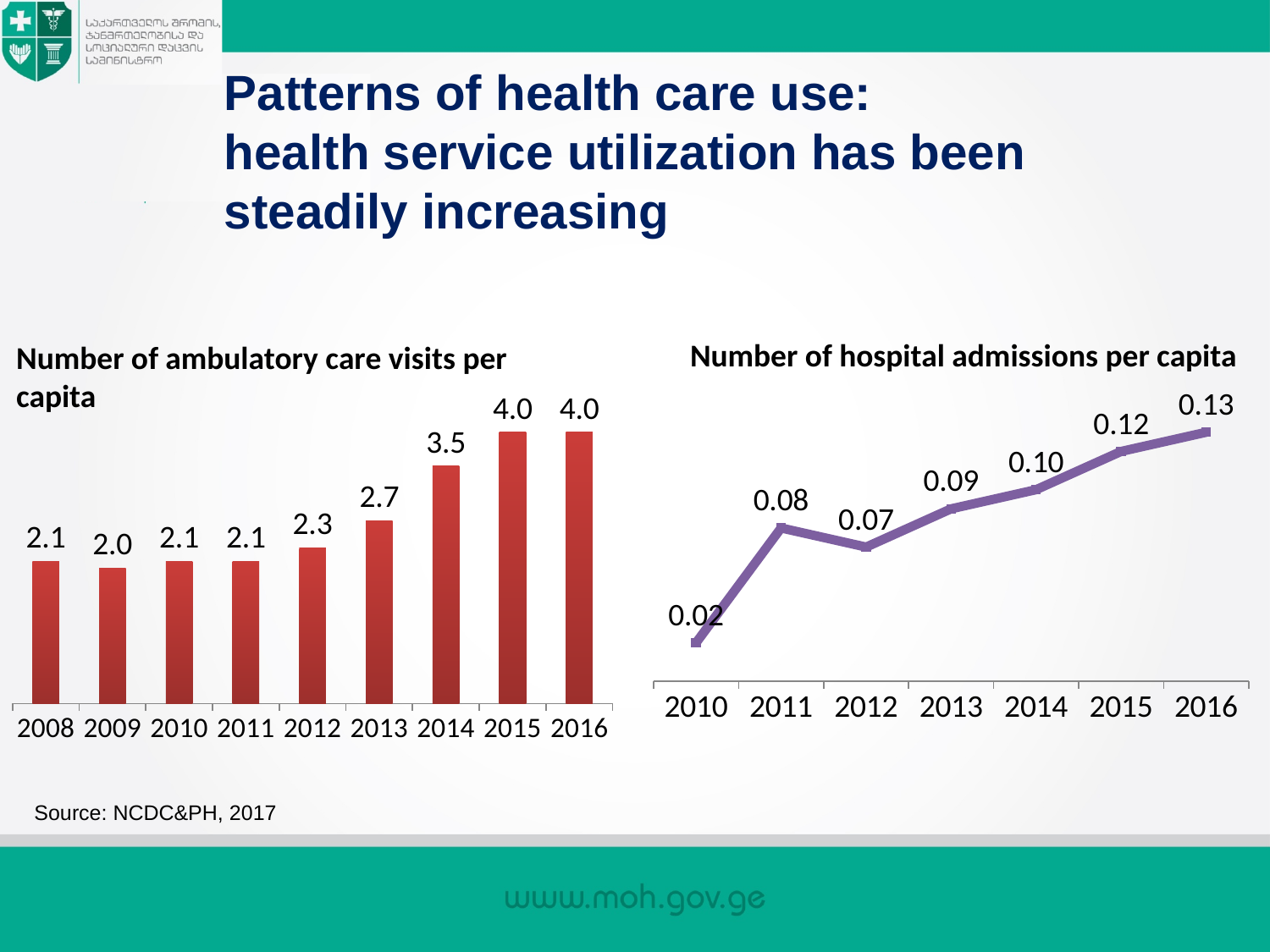
In the 'Number of hospital admissions per capita' chart, do the values generally rise or fall from 2010 to 2016? Rise In the 'Number of hospital admissions per capita' chart, what is the value for 2012? 0.07 In the 'Number of hospital admissions per capita' chart, what is the difference between the values for 2011 and 2010? 0.06 In the 'Number of ambulatory care visits per capita' chart, what is the difference between the values for 2016 and 2008? 1.9 What source is cited at the bottom of the slide for the charts? NCDC&PH, 2017 In the 'Number of hospital admissions per capita' chart, which year has the highest value? 2016 In the 'Number of ambulatory care visits per capita' chart, which year has the lowest value? 2009 In the 'Number of ambulatory care visits per capita' chart, is the value for 2013 larger or smaller than the value for 2012? Larger In the 'Number of ambulatory care visits per capita' chart, how many years are shown on the x axis? 9 What kind of chart is the 'Number of hospital admissions per capita' chart? Line chart In the 'Number of ambulatory care visits per capita' chart, what is the value for 2014? 3.5 What kind of chart is the 'Number of ambulatory care visits per capita' chart? Bar chart